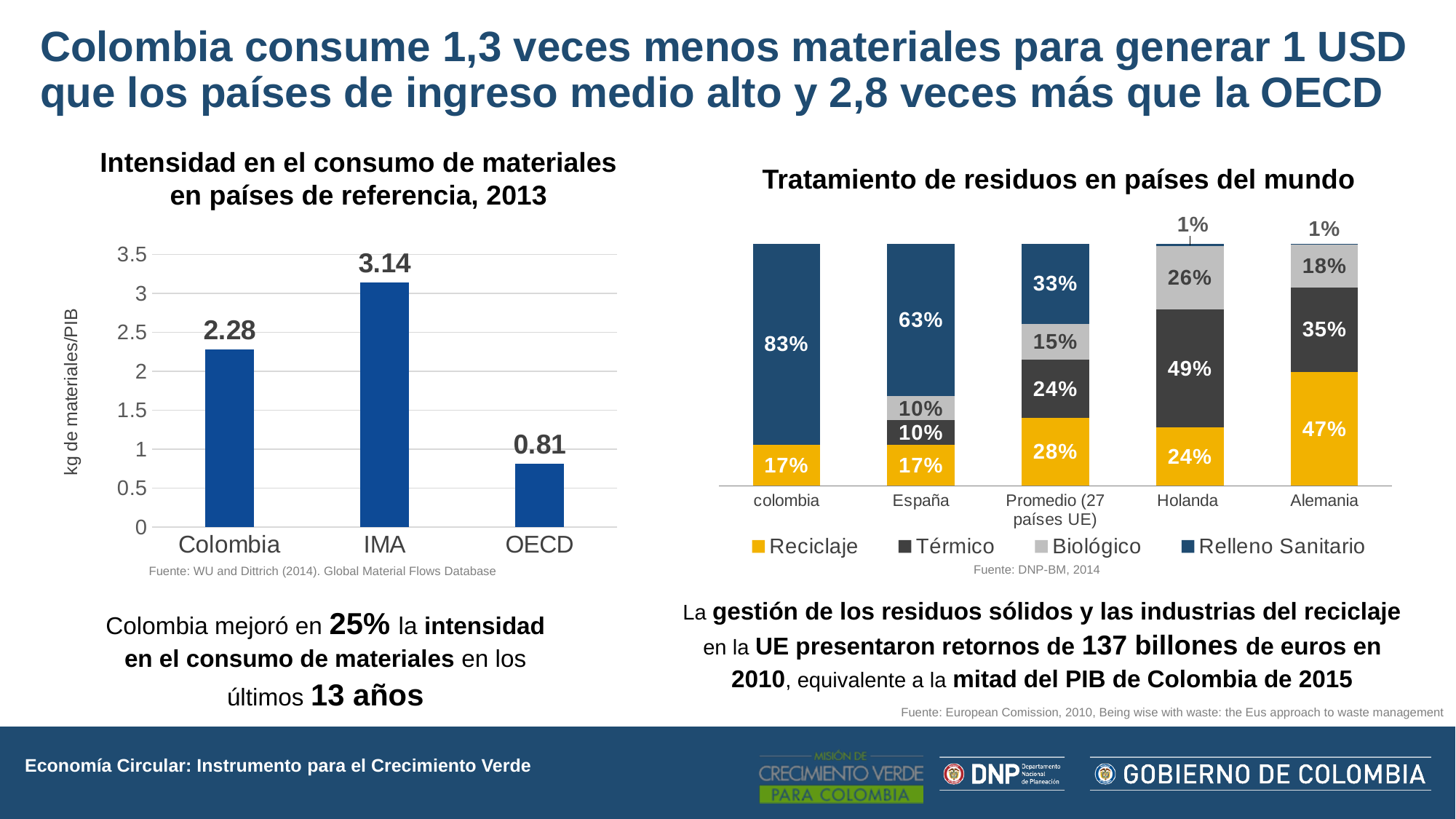
What type of chart is 'Intensidad en el consumo de materiales en países de referencia, 2013'? Bar chart In the chart 'Tratamiento de residuos en países del mundo', how many series does the legend list? 4 In the chart 'Tratamiento de residuos en países del mundo', what is the Reciclaje share for Alemania? 47% In the chart 'Intensidad en el consumo de materiales en países de referencia, 2013', what is the value for Colombia? 2.28 In the chart 'Intensidad en el consumo de materiales en países de referencia, 2013', what is the difference between the values for IMA and Colombia? 0.86 In the chart 'Intensidad en el consumo de materiales en países de referencia, 2013', which category has the highest value? IMA In the chart 'Intensidad en el consumo de materiales en países de referencia, 2013', how many categories are shown? 3 In the chart 'Intensidad en el consumo de materiales en países de referencia, 2013', which category has the lowest value? OECD In the chart 'Tratamiento de residuos en países del mundo', what is the difference between the Relleno Sanitario shares of España and Promedio (27 países UE)? 30% In the chart 'Tratamiento de residuos en países del mundo', what is the Relleno Sanitario share for colombia? 83% In the chart 'Tratamiento de residuos en países del mundo', which country has the highest Reciclaje share? Alemania In the chart 'Tratamiento de residuos en países del mundo', is the Térmico share larger for Holanda or for Alemania? Holanda